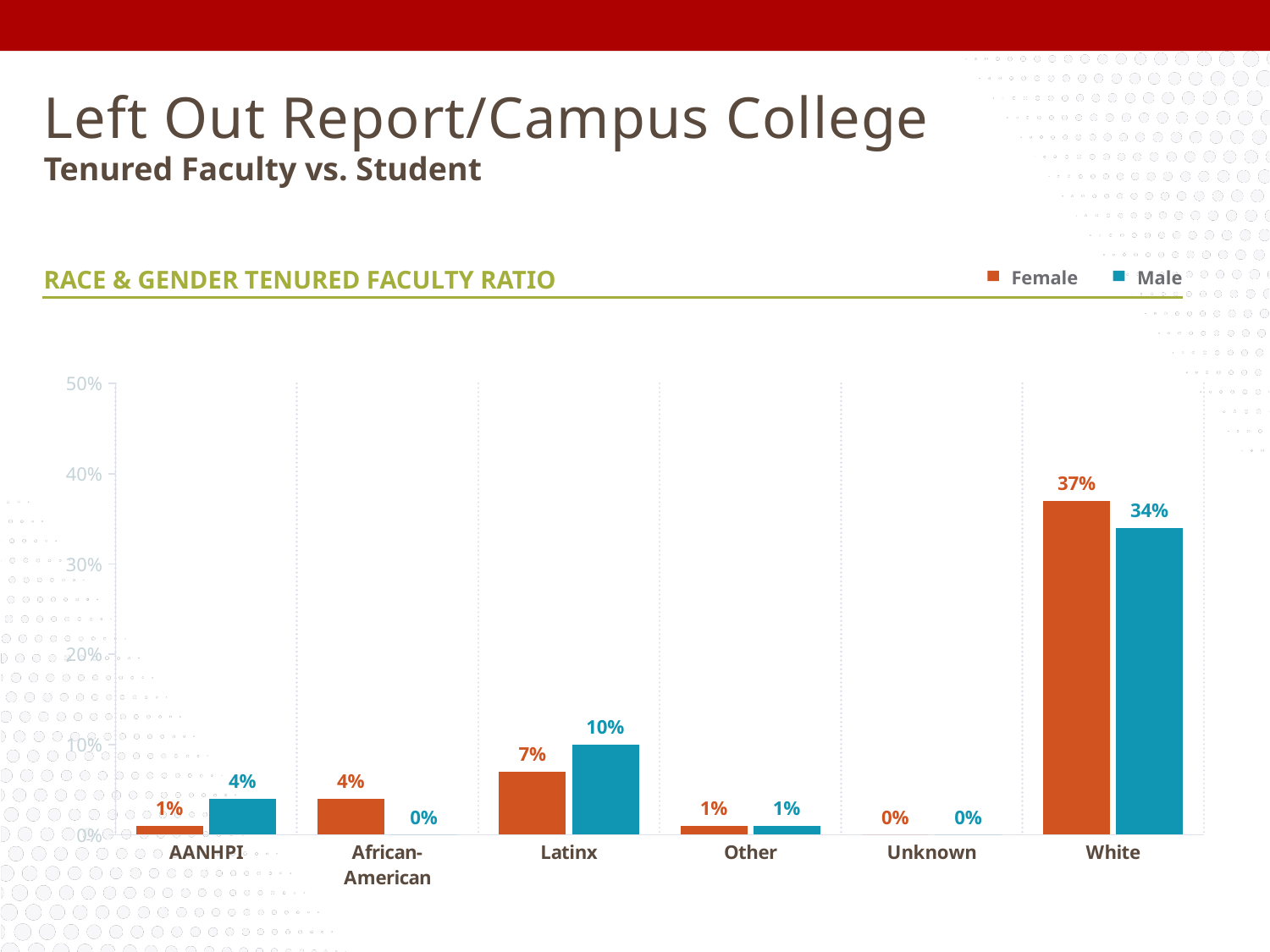
What is the difference between the Female and Male values for White? 3% What is the Female value for AANHPI? 1% What is the Female value for White? 37% What is the Male value for African-American? 0% Which category has the lowest Female value? Unknown What is the title of the chart? RACE & GENDER TENURED FACULTY RATIO What kind of chart is shown on the slide? Bar chart Which is larger for Latinx, the Female value or the Male value? Male How many series does the legend list? 2 Which category has the highest Male value? White What is the Male value for Latinx? 10% How many categories are shown on the x axis? 6